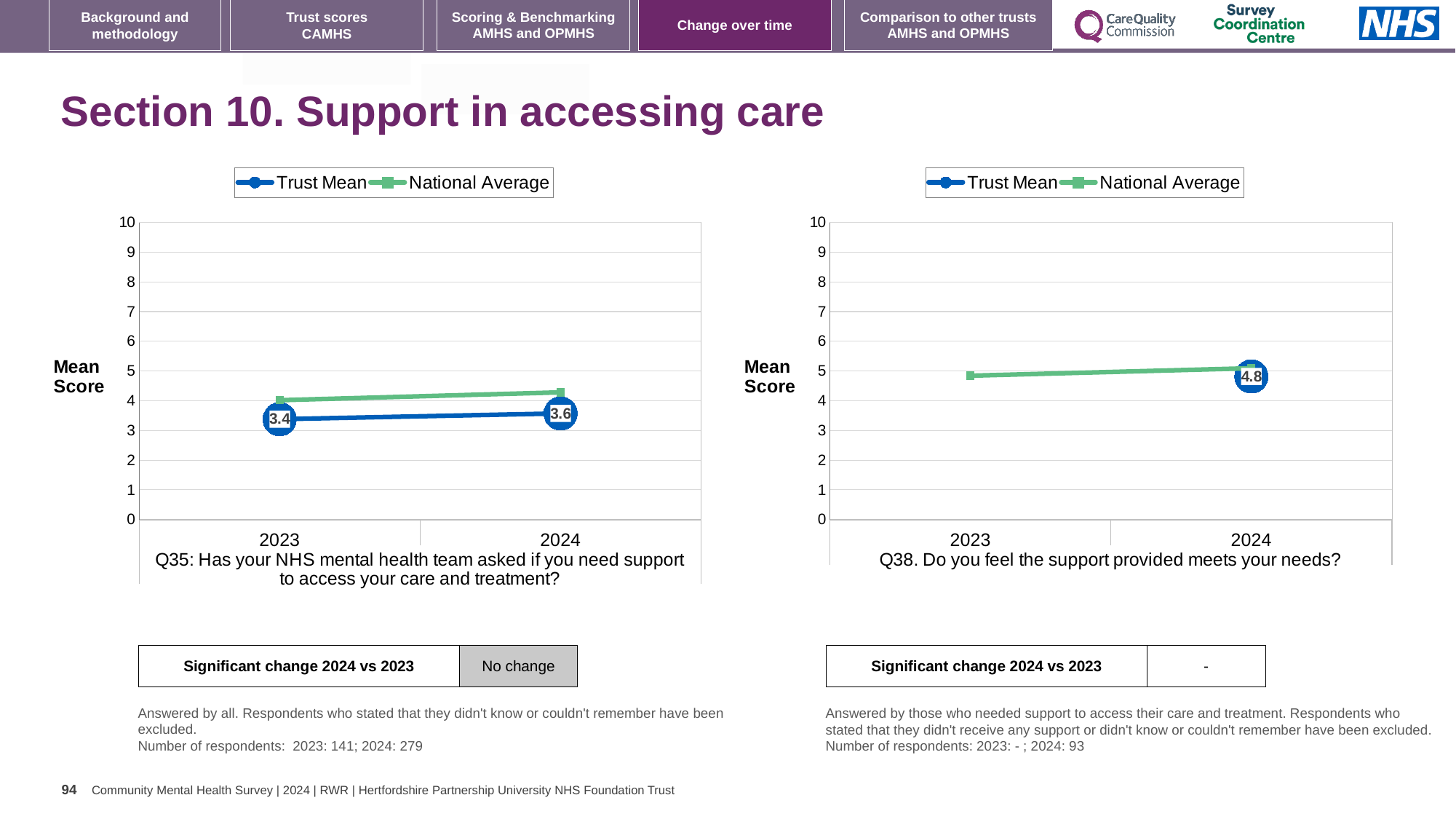
In the right chart (Q38), what is the Trust Mean score for 2024? 4.8 In the left chart (Q35), what is the Trust Mean score for 2024? 3.6 How many series does the legend of the right chart (Q38) list? 2 In the left chart (Q35), does the Trust Mean rise or fall from 2023 to 2024? rise In the left chart (Q35), which is larger in 2023: the Trust Mean or the National Average? National Average In the left chart (Q35), what is the Trust Mean score for 2023? 3.4 In the left chart (Q35), by how much did the Trust Mean change from 2023 to 2024? 0.2 How many years are shown on the x axis of the left chart (Q35)? 2 What are the two legend entries shown above the left chart (Q35)? Trust Mean and National Average In the left chart (Q35), is the National Average for 2023 greater or less than 3? greater In the left chart (Q35), which year has the higher Trust Mean, 2023 or 2024? 2024 What kind of chart is the left chart (Q35)? line chart